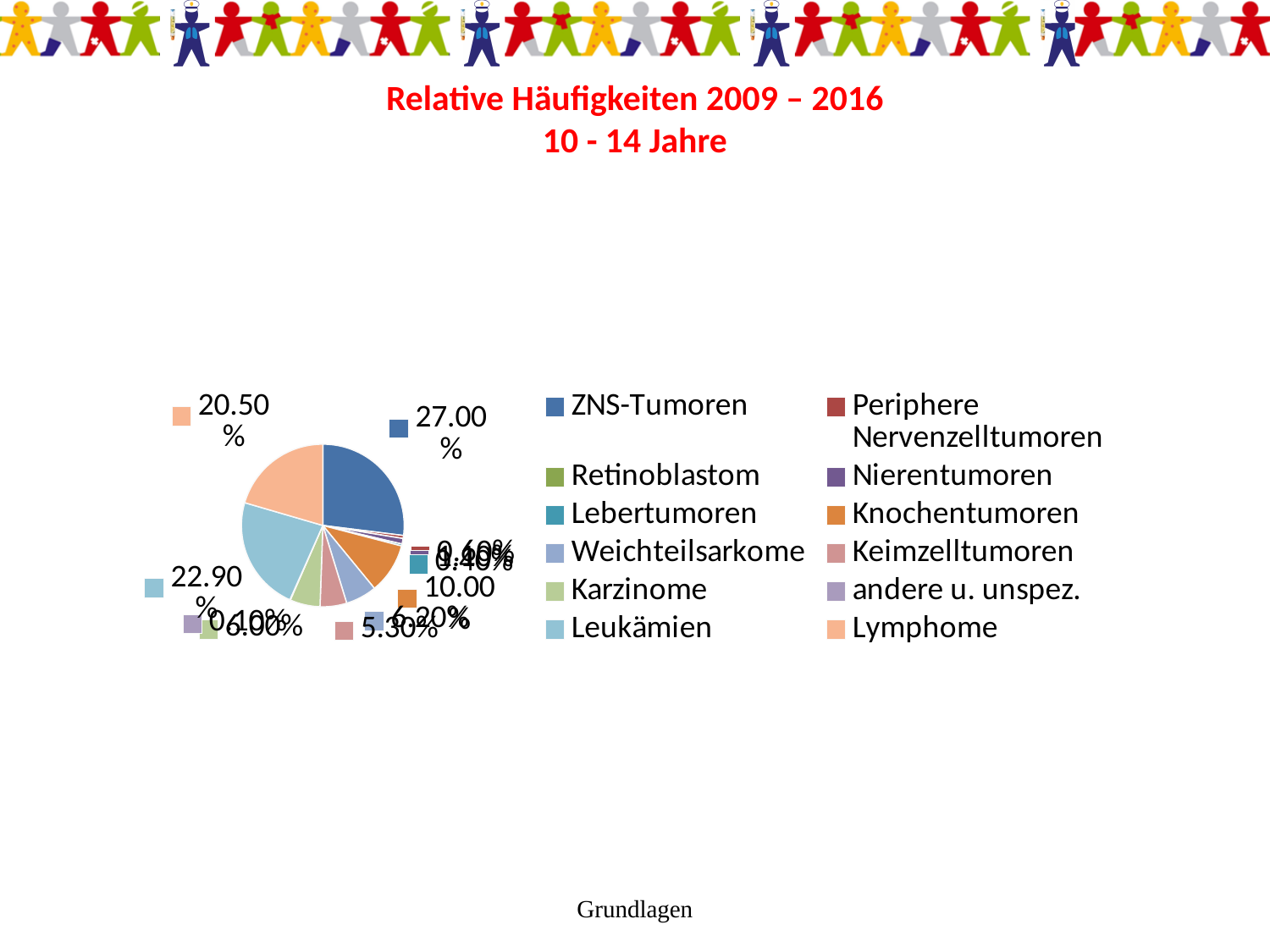
What kind of chart is shown on the slide? pie chart What share of the pie does Keimzelltumoren have? 5.30% What is the difference between the shares of ZNS-Tumoren and Leukämien? 4.10% What is the title of the chart on the slide? Relative Häufigkeiten 2009 – 2016 10 - 14 Jahre What share of the pie does Lymphome have? 20.50% What share of the pie does ZNS-Tumoren have? 27.00% How many categories does the legend of the pie chart list? 12 What share of the pie does Leukämien have? 22.90% Which slice is larger, Leukämien or Lymphome? Leukämien Which category has the largest slice of the pie? ZNS-Tumoren Which slice is larger, Knochentumoren or Keimzelltumoren? Knochentumoren What share of the pie does Knochentumoren have? 10.00%